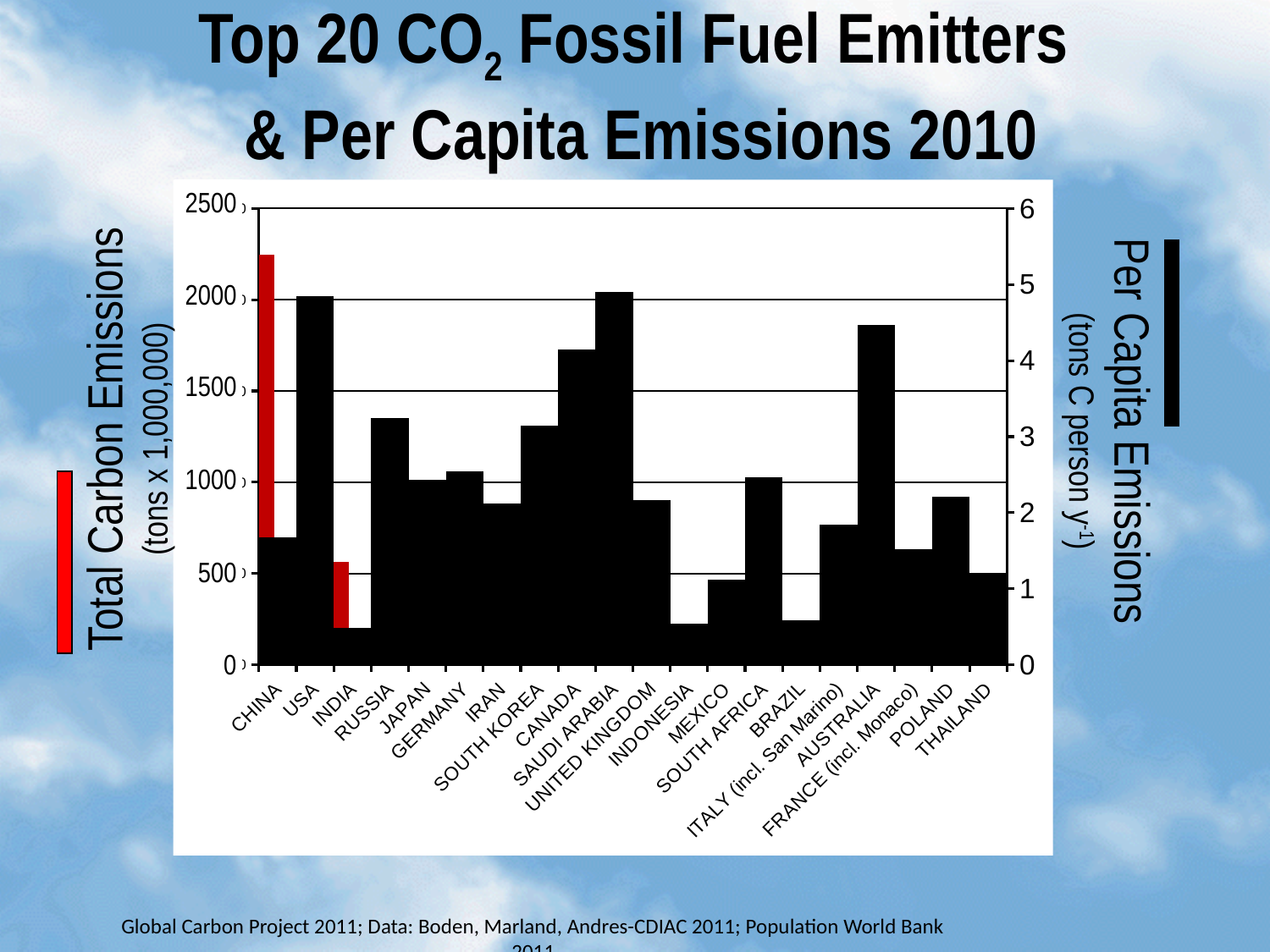
Is the Per Capita Emissions value for USA greater or less than 4? greater How many series does the chart's legend list? 2 How many countries are shown along the x axis of the chart? 20 Which has the higher Per Capita Emissions value, CANADA or JAPAN? CANADA What kind of chart is shown on the slide? bar chart Is the Total Carbon Emissions value for CHINA greater or less than 2000? greater Is the Total Carbon Emissions value for INDIA greater or less than 1000? less What colour are the Total Carbon Emissions bars in the chart? red Which has the higher Total Carbon Emissions value, CHINA or INDIA? CHINA Which has the higher Per Capita Emissions value, RUSSIA or MEXICO? RUSSIA